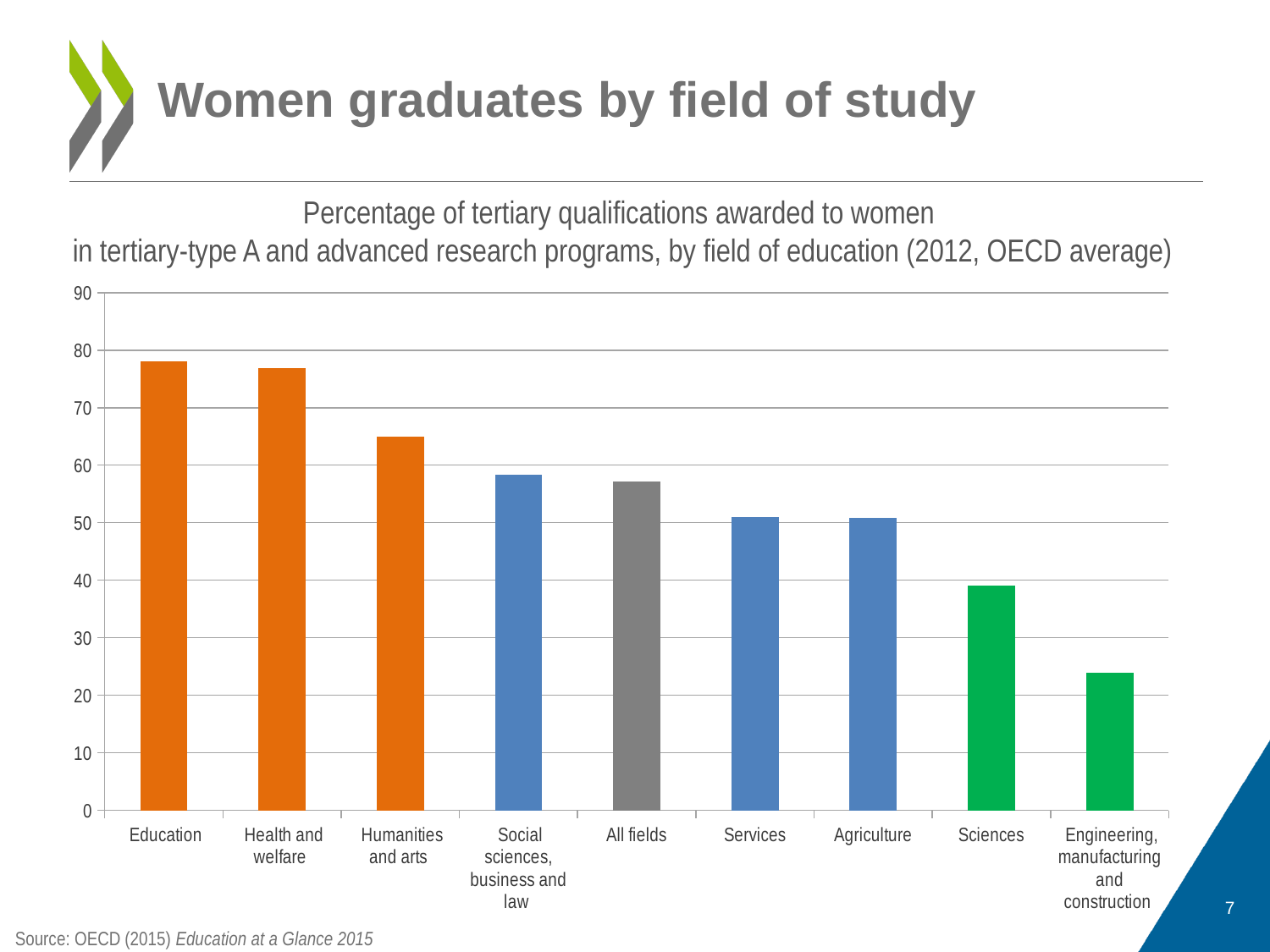
Is the value for Sciences greater or less than 30? greater Is the value for All fields greater or less than 50? greater Which has a higher value, Humanities and arts or Social sciences, business and law? Humanities and arts What colour is the bar for All fields? grey Is the value for Education greater or less than 70? greater Which has a higher value, Sciences or Engineering, manufacturing and construction? Sciences What kind of chart is shown on the slide? bar chart Which field of education has the lowest percentage of tertiary qualifications awarded to women? Engineering, manufacturing and construction How many fields of education are shown on the x axis of the chart? 9 Do the values rise or fall moving from left to right along the x axis? fall